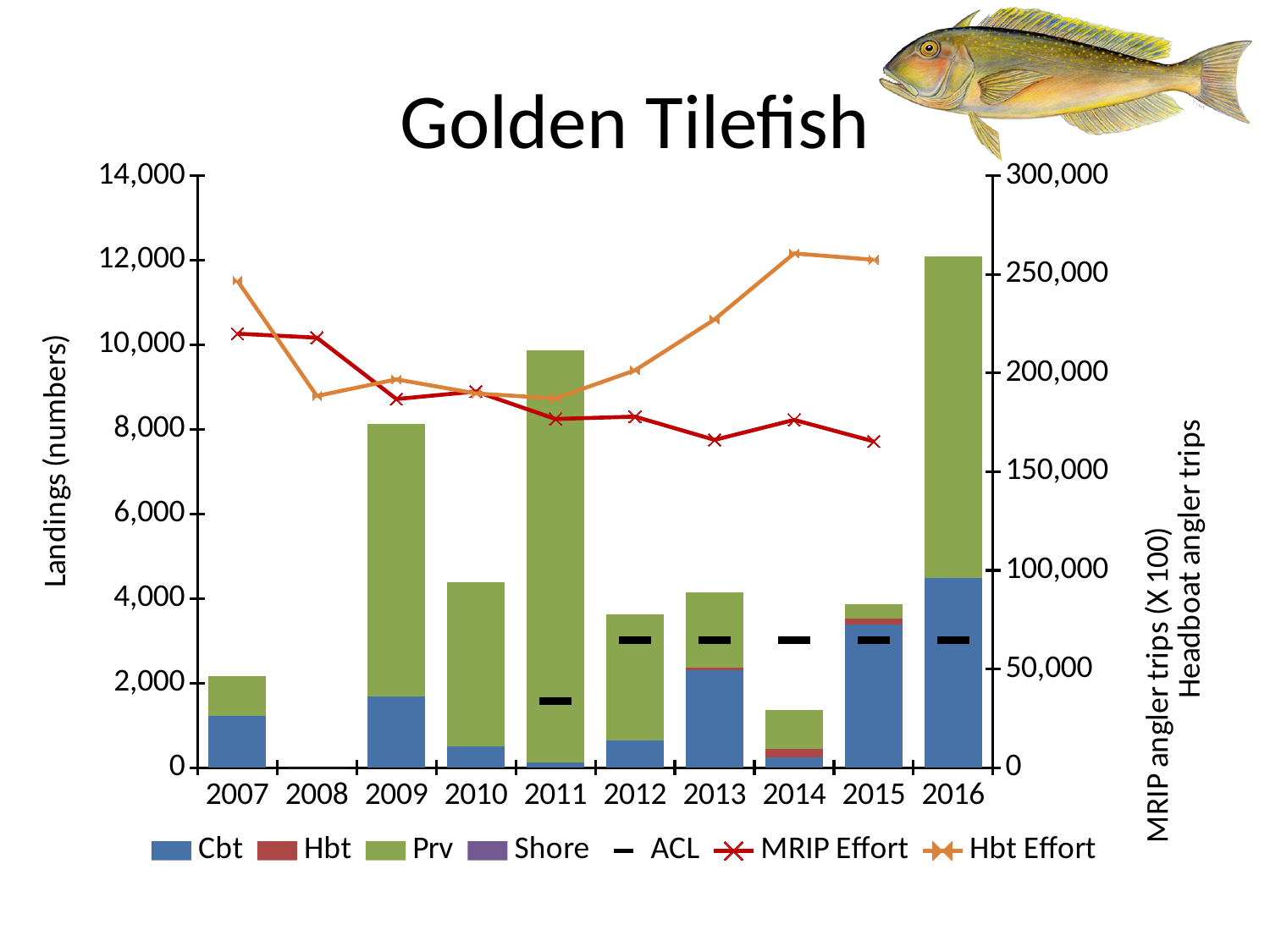
What kind of chart is this? Bar chart combined with line series Is the total landings bar for 2010 greater or less than 4,000? greater Which year has the larger total landings bar, 2009 or 2010? 2009 Does the Hbt Effort line rise or fall from 2012 to 2014? rise Is the total landings bar for 2014 greater or less than 2,000? less Is the Hbt Effort value for 2014 greater or less than 250,000? greater Which year has the tallest stacked landings bar? 2016 How many series does the legend list? 7 How many years are shown on the x axis? 10 What is the title of the chart? Golden Tilefish